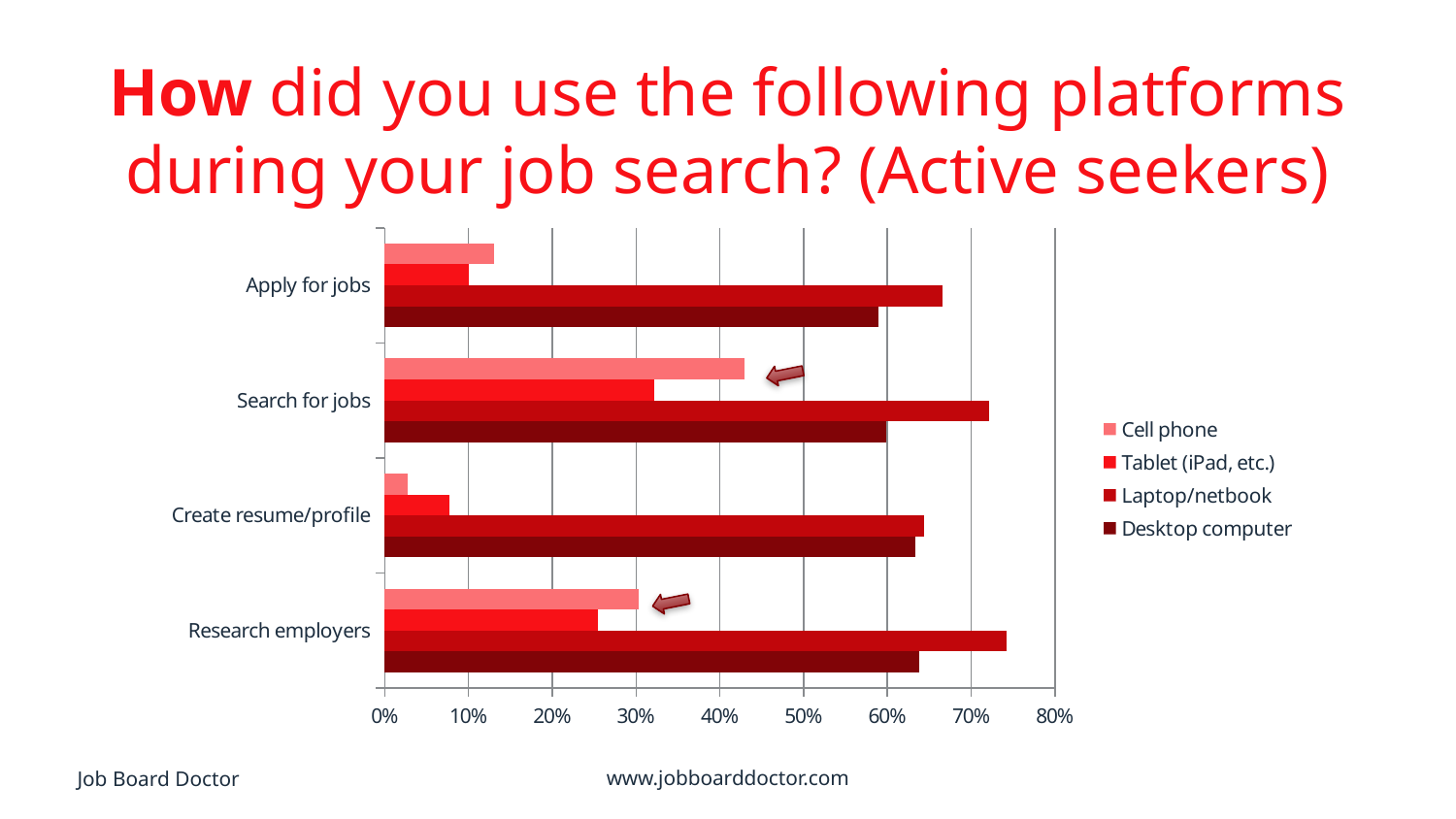
Is the Tablet (iPad, etc.) value for Apply for jobs greater or less than 20%? less Which series is shown in the lightest pink colour in the legend? Cell phone How many series does the legend list? 4 Which activity has the lowest Cell phone value? Create resume/profile What kind of chart is shown on the slide? Bar chart Which activity has the highest Cell phone value? Search for jobs Is the Desktop computer value for Create resume/profile greater or less than 50%? greater Is the Cell phone value for Search for jobs greater or less than 40%? greater How many activity categories are shown on the vertical axis? 4 For Search for jobs, which is larger: the Cell phone value or the Tablet (iPad, etc.) value? Cell phone For Apply for jobs, which is larger: the Laptop/netbook value or the Desktop computer value? Laptop/netbook